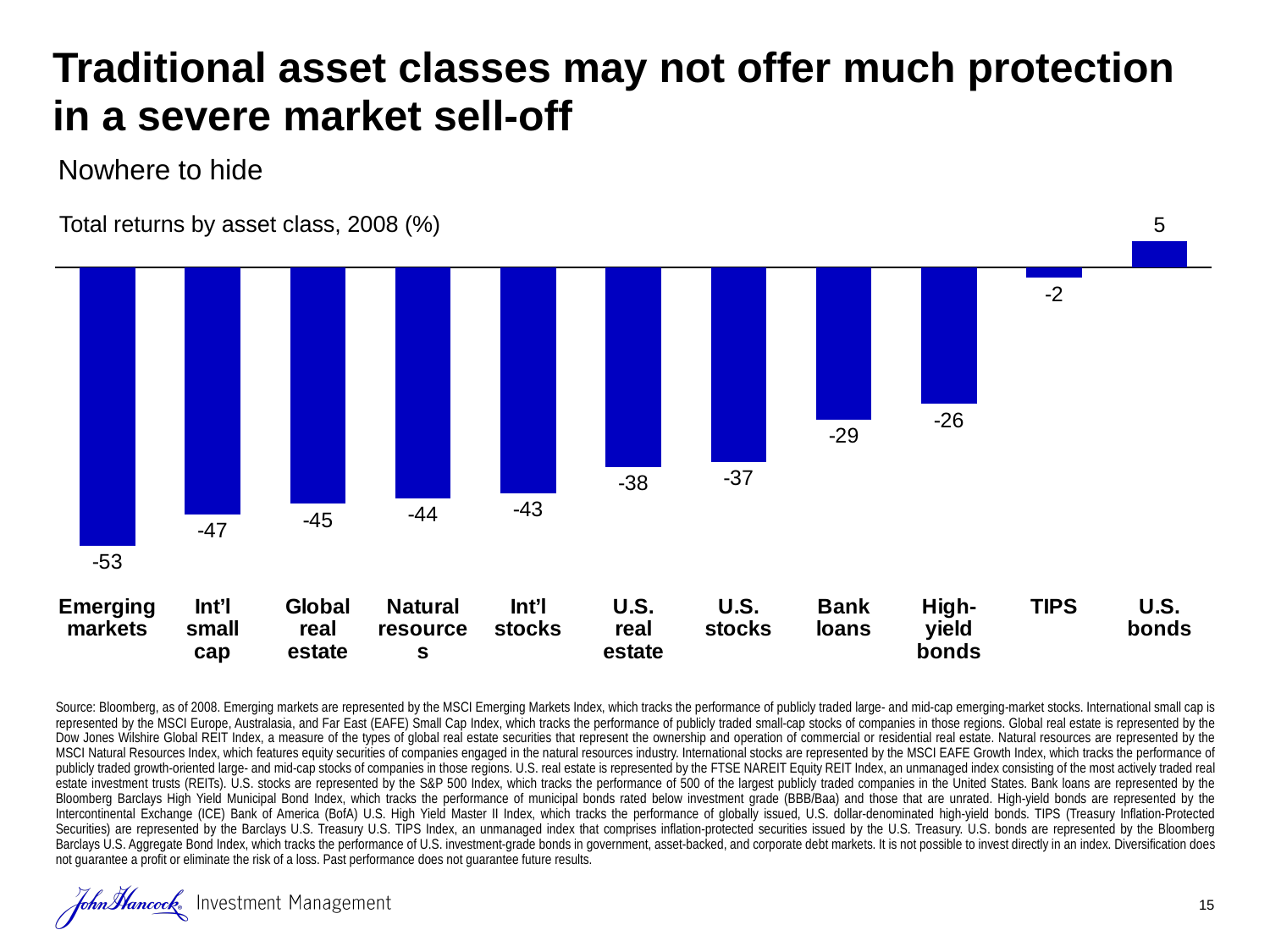
What is the title of the chart? Total returns by asset class, 2008 (%) What was the total return for Emerging markets in 2008? -53 Which asset class had the lowest total return in 2008? Emerging markets What is the difference between the returns of U.S. stocks and U.S. real estate? 1 Which had a higher return in 2008, High-yield bonds or Int'l stocks? High-yield bonds What type of chart is shown on the slide? Bar chart How many asset classes had a positive return in 2008? 1 What was the total return for TIPS in 2008? -2 Which asset class had the highest total return in 2008? U.S. bonds How many asset classes are shown in the chart? 11 What was the total return for U.S. bonds in 2008? 5 What was the total return for Bank loans in 2008? -29